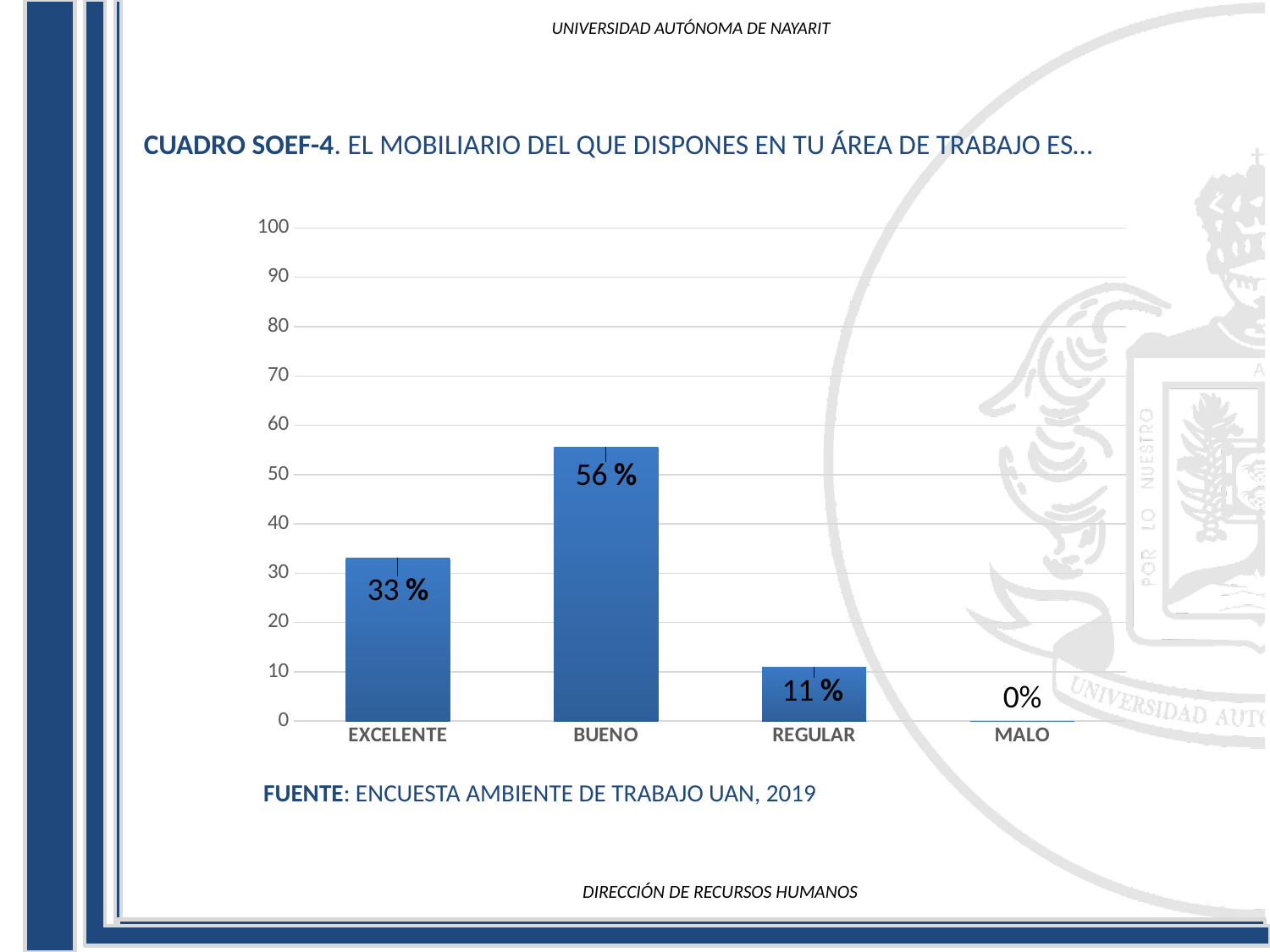
Which category has the highest value? BUENO What is the difference between the values for BUENO and EXCELENTE? 23 % What is the value for MALO? 0% Which is larger, the value for EXCELENTE or the value for REGULAR? EXCELENTE Which category has the lowest value? MALO What is the value for EXCELENTE? 33 % Is the value for BUENO greater or less than 50? greater What is the value for REGULAR? 11 % What is the source cited below the chart? ENCUESTA AMBIENTE DE TRABAJO UAN, 2019 What is the value for BUENO? 56 % What kind of chart is shown on the slide? bar chart How many categories are shown on the x axis? 4